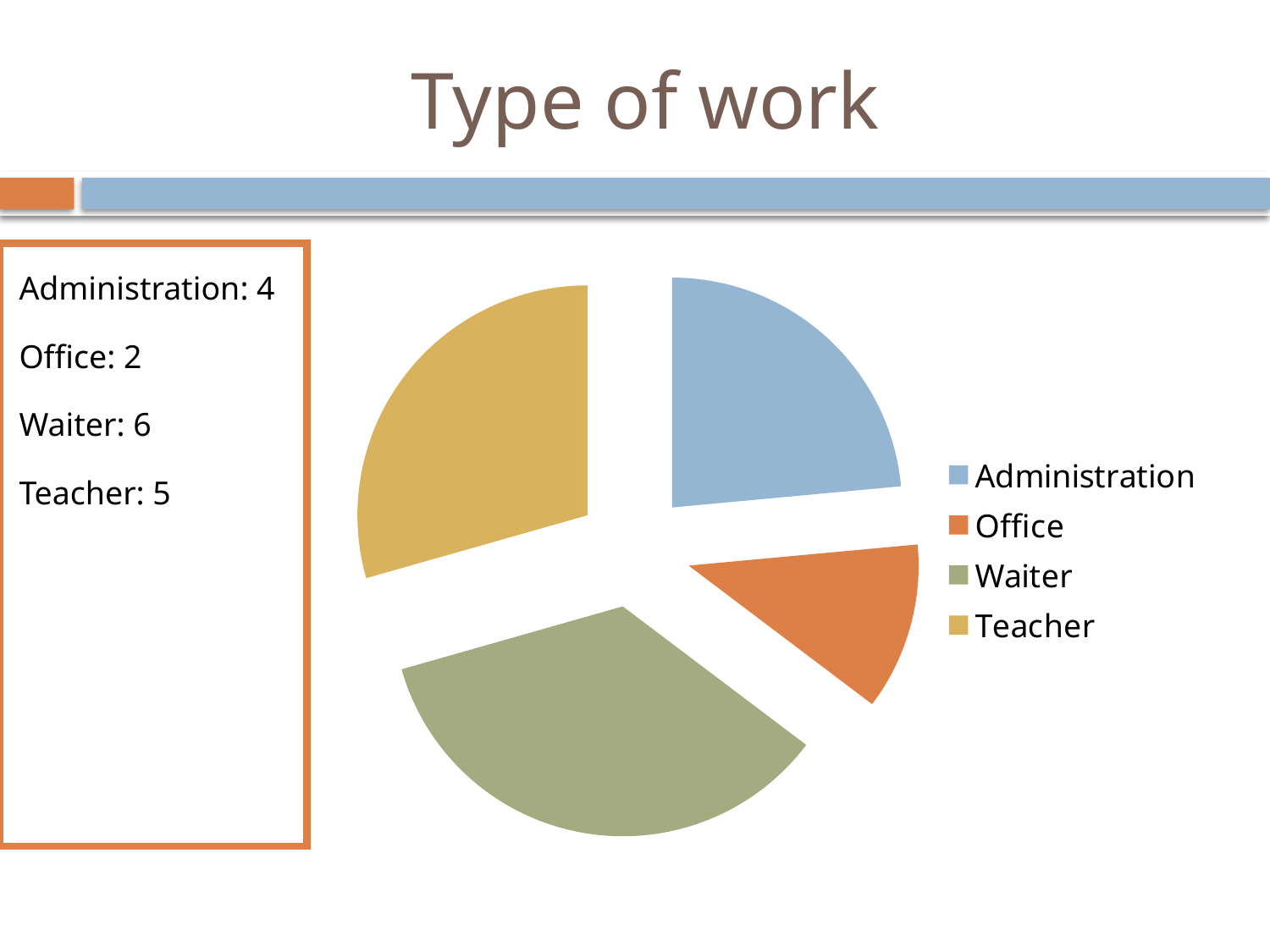
What type of chart is shown on the slide? pie chart Which type of work has the largest slice of the pie? Waiter What is the value for Office? 2 What is the title of the slide containing the pie chart? Type of work How many categories does the pie chart have? 4 What is the value for Administration? 4 What is the value for Waiter? 6 Which is larger, the value for Teacher or the value for Administration? Teacher What is the difference between the values for Teacher and Administration? 1 What is the value for Teacher? 5 Which type of work has the smallest slice of the pie? Office What is the difference between the values for Waiter and Office? 4